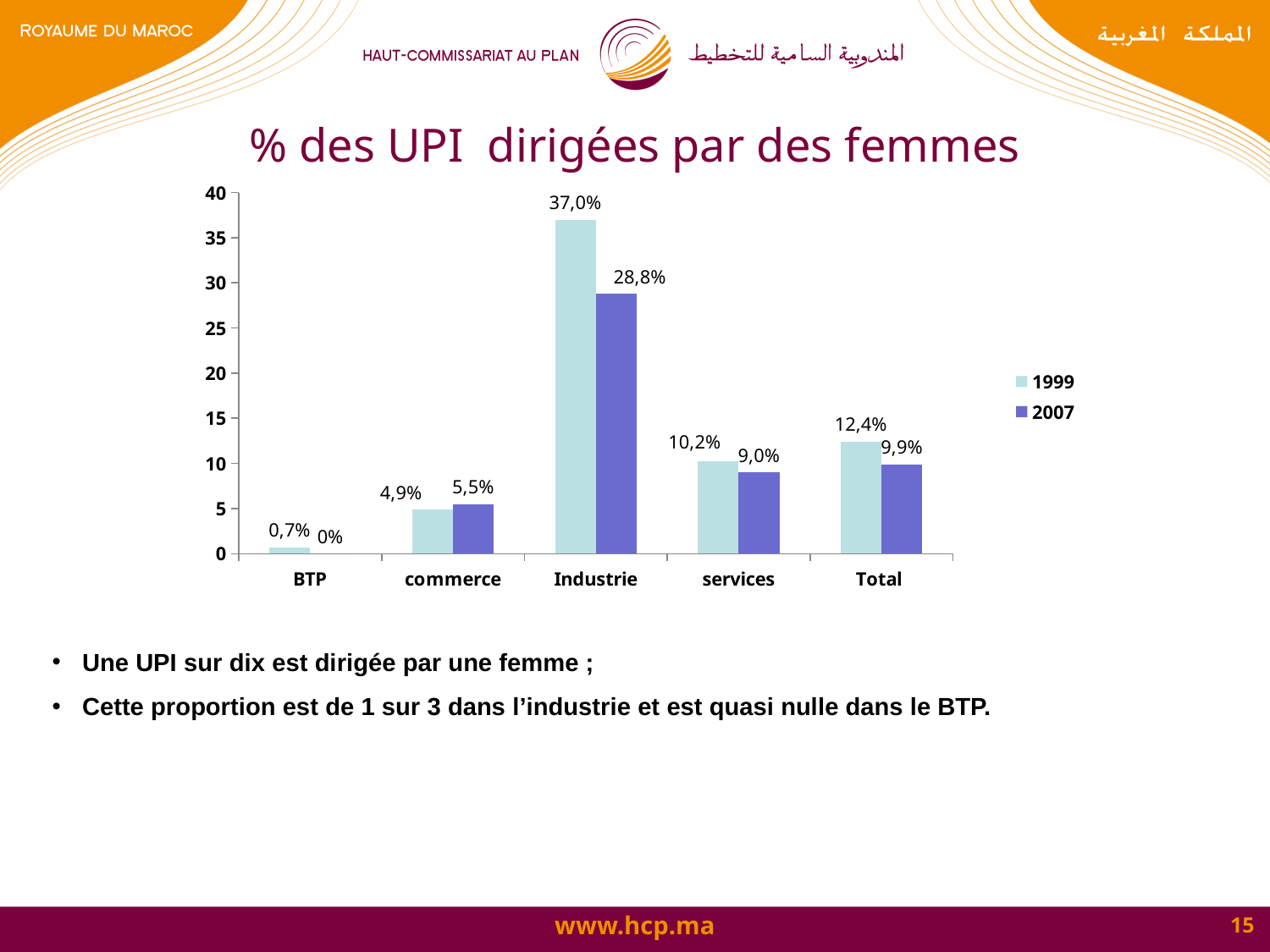
What is the value for Total in 2007? 9,9% Which category has the highest value in 2007? Industrie What kind of chart is shown on the slide? bar chart Which is larger for commerce: the 1999 value or the 2007 value? 2007 What is the value for services in 1999? 10,2% Which category has the lowest value in 1999? BTP How many categories are shown on the x axis? 5 What is the value for Industrie in 1999? 37,0% What is the value for BTP in 2007? 0% Is the value for Industrie in 2007 greater or less than 25? greater How many series does the legend list? 2 What is the difference between the 1999 and 2007 values for Industrie? 8,2%